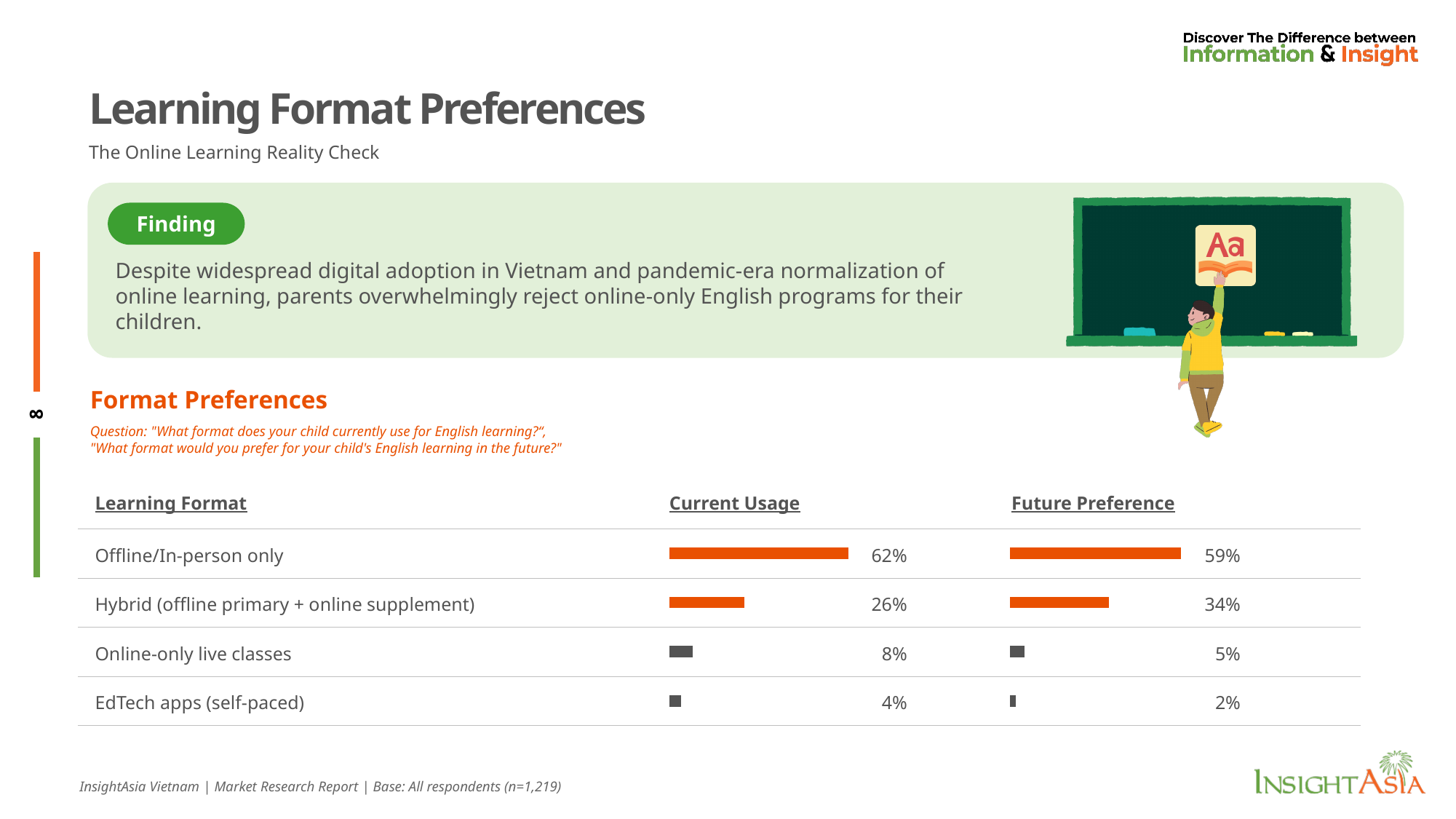
Which is larger for Online-only live classes: Current Usage or Future Preference? Current Usage What is the difference between Current Usage and Future Preference for Offline/In-person only? 3% Which learning format has the highest Future Preference value? Offline/In-person only What kind of chart is used to show the Format Preferences data? Bar chart How many learning formats are listed in the Format Preferences chart? 4 Which learning format has the lowest Current Usage value? EdTech apps (self-paced) How many data series (columns of values) does the Format Preferences chart show? 2 What is the Current Usage value for Offline/In-person only? 62% What is the difference between Current Usage and Future Preference for Hybrid (offline primary + online supplement)? 8% What is the Future Preference value for EdTech apps (self-paced)? 2% What is the Future Preference value for Hybrid (offline primary + online supplement)? 34% What is the Current Usage value for Online-only live classes? 8%